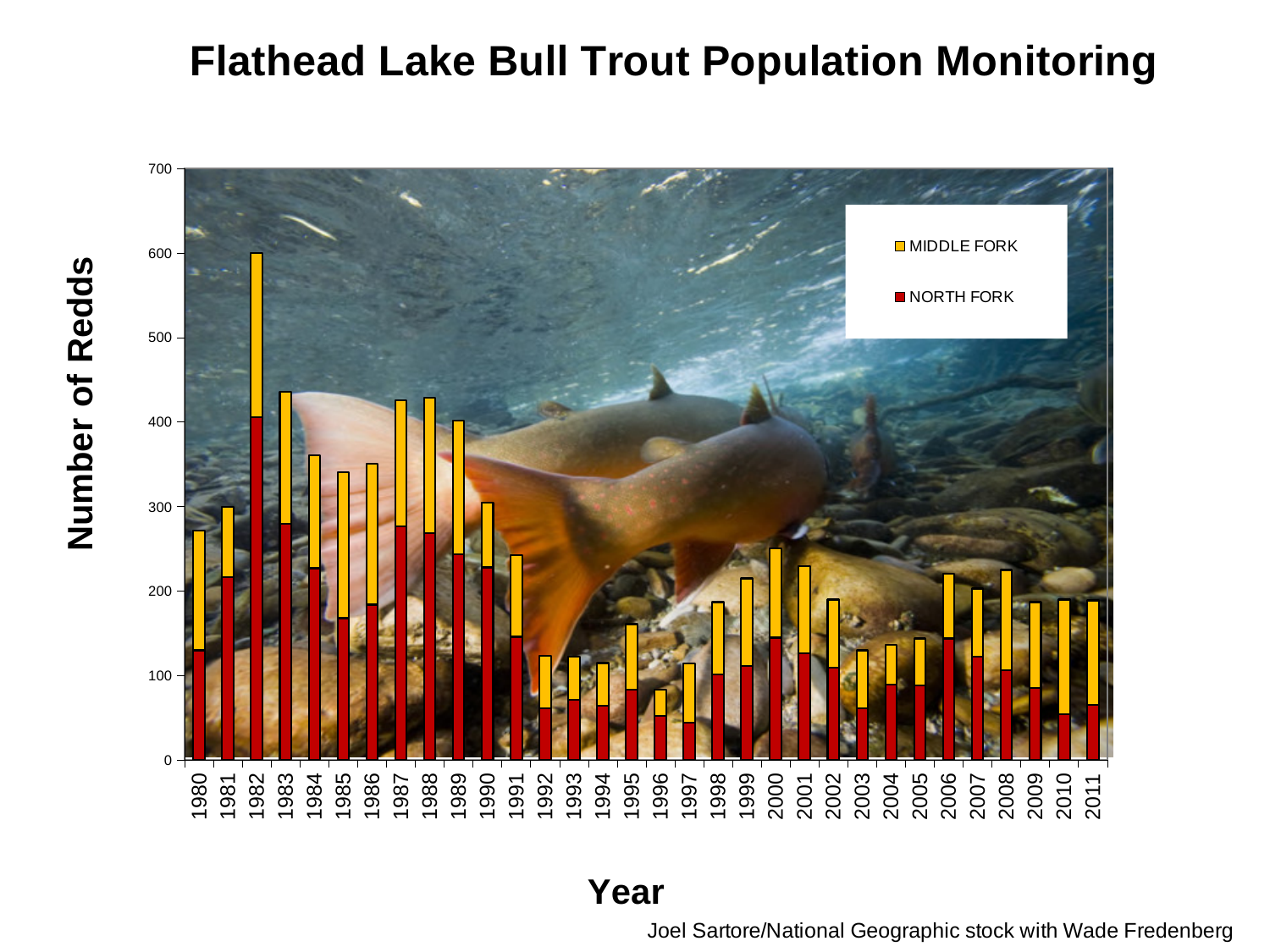
What is the title of the y axis? Number of Redds Which year has the lowest total number of redds? 1996 Which year has a larger total number of redds, 1987 or 1996? 1987 Is the total number of redds for 1996 greater or less than 100? less Which year has the highest total number of redds? 1982 Is the total number of redds for 1982 greater or less than 500? greater Between 1982 and 1996, do the total bar heights generally rise or fall? fall Is the NORTH FORK value for 1982 greater or less than 300? greater What kind of chart is shown on the slide? Stacked bar chart How many series does the legend list? 2 How many years are shown along the x axis? 32